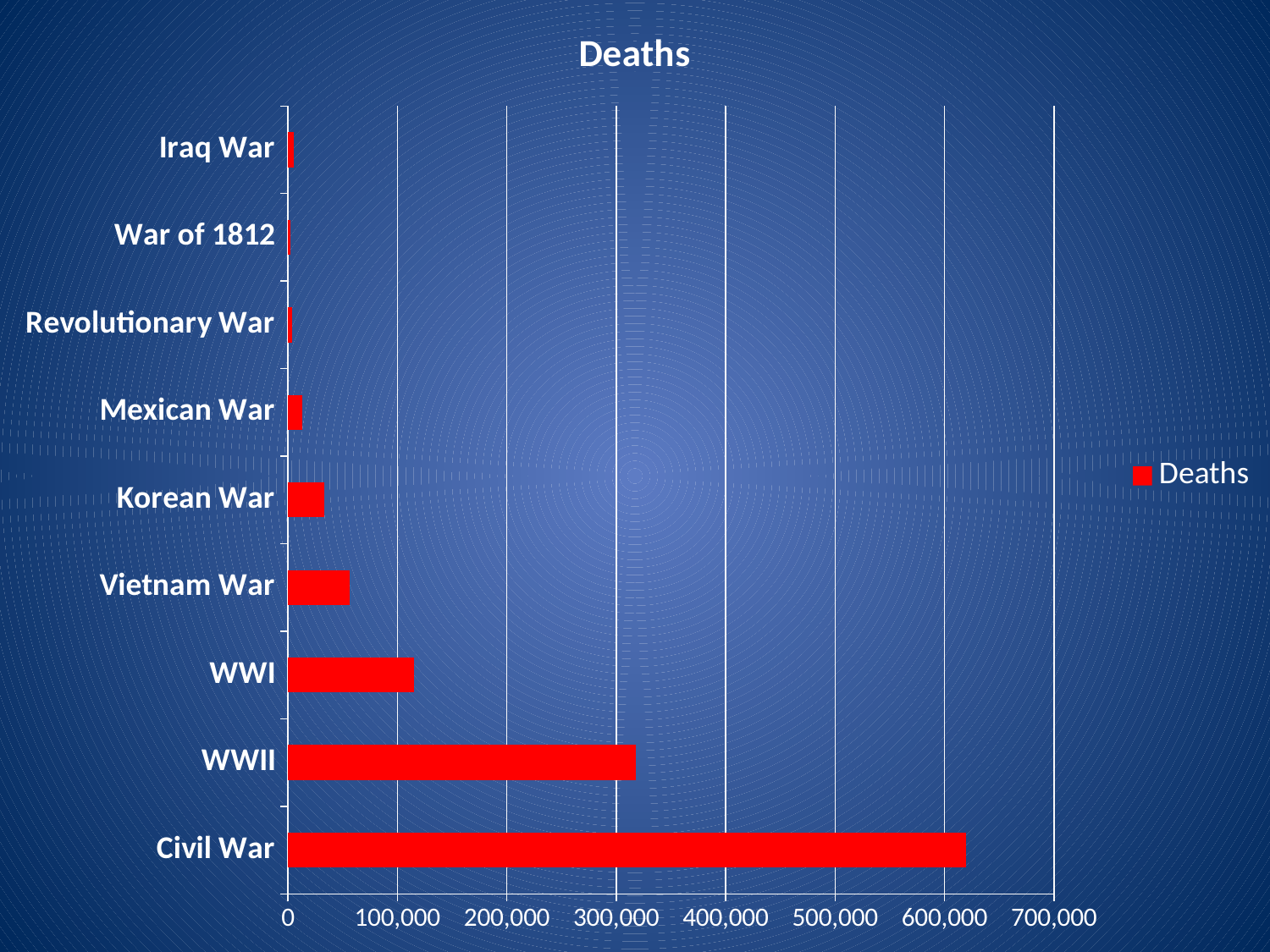
Is the value for Vietnam War greater or less than 100,000? less Which has more deaths, WWII or WWI? WWII What colour are the bars in the chart? red How many series does the legend list? 1 Which war has the highest number of deaths? Civil War Which has more deaths, Vietnam War or Korean War? Vietnam War How many wars (categories) are plotted on the chart? 9 Is the value for WWI greater or less than 100,000? greater What is the title of the chart? Deaths What kind of chart is shown on the slide? bar chart Is the value for WWII greater or less than 300,000? greater